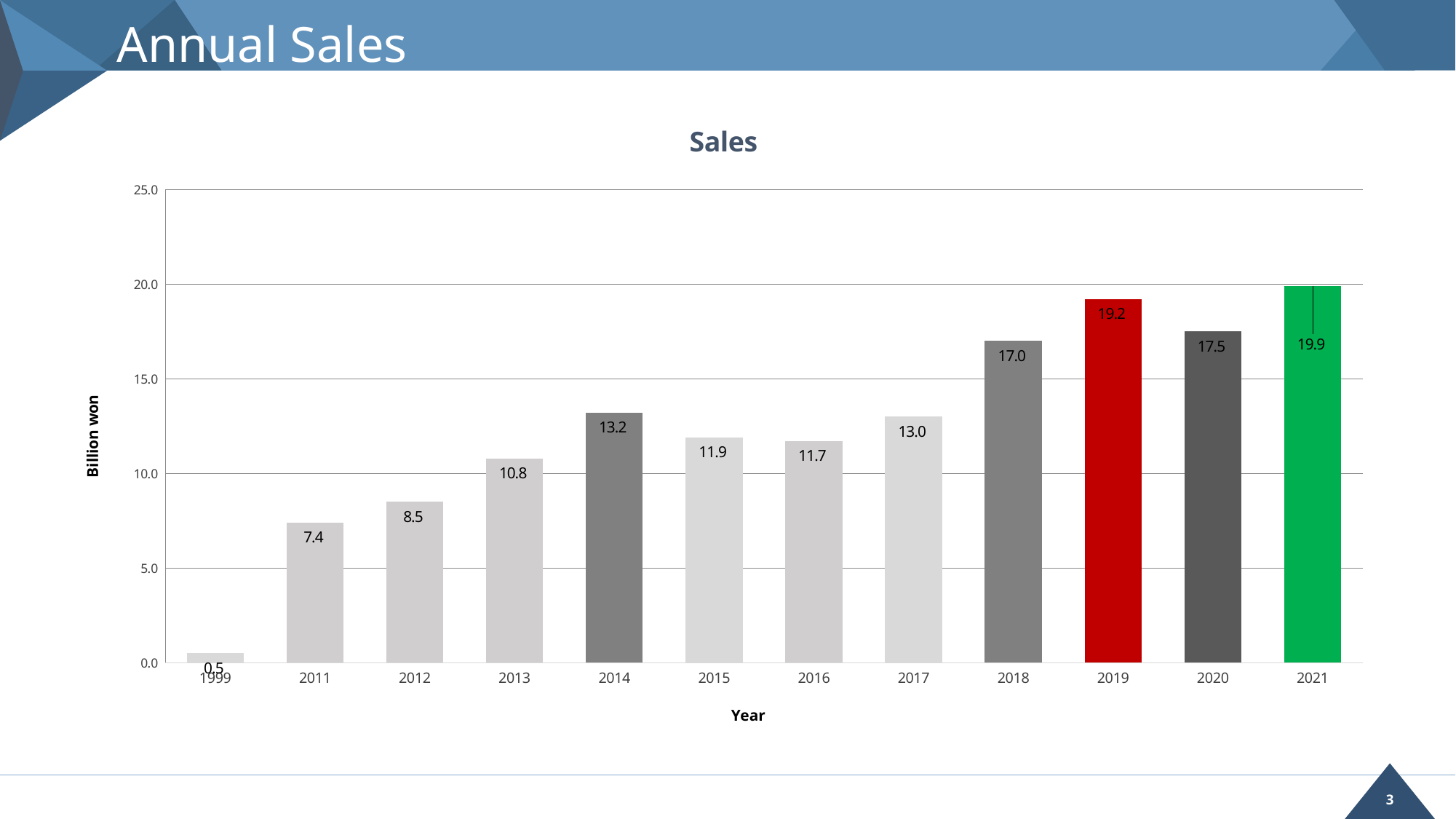
What kind of chart is shown on the slide? bar chart Is the sales value for 2013 greater or less than 10.0? greater How many years are shown on the x axis? 12 What is the difference in sales between 2019 and 2018? 2.2 What is the label of the vertical axis? Billion won What is the sales value for 2019? 19.2 What is the sales value for 2014? 13.2 Which year has higher sales, 2015 or 2016? 2015 Which year has the lowest sales? 1999 What is the difference in sales between 2021 and 2020? 2.4 What is the sales value for 1999? 0.5 Which year has the highest sales? 2021